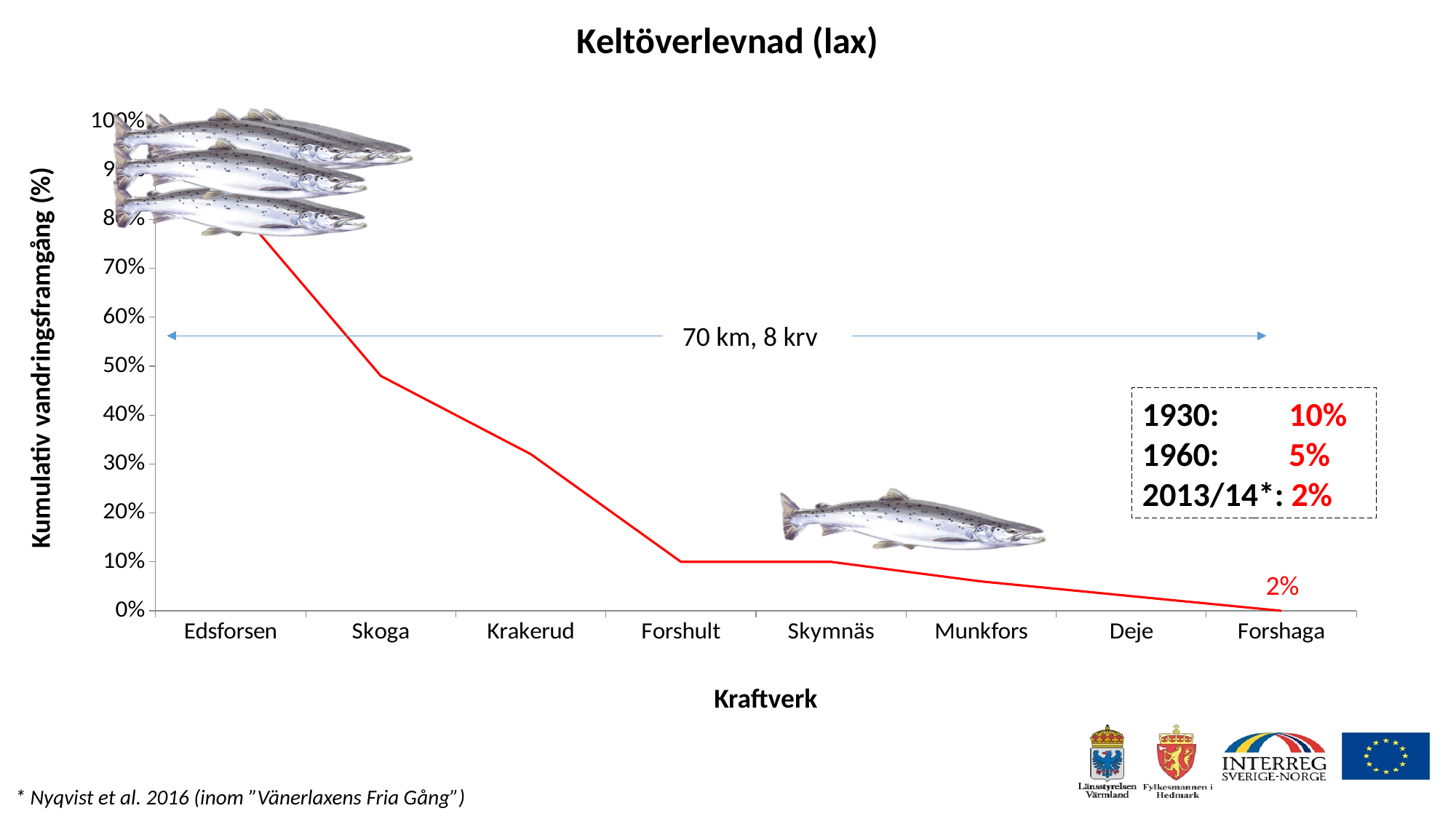
How many power stations (categories) are shown along the x axis? 8 Which power station has the lowest cumulative migration success? Forshaga Which has the larger value, Skoga or Krakerud? Skoga Do the values rise or fall along the x axis from Edsforsen to Forshaga? fall What is the label of the x axis? Kraftverk What is the cumulative migration success value at Forshult? 10% What is the title of the chart? Keltöverlevnad (lax) Which power station has the highest cumulative migration success? Edsforsen Is the value for Skoga greater or less than 40%? greater What kind of chart is shown on the slide? line chart Is the value for Munkfors greater or less than 10%? less